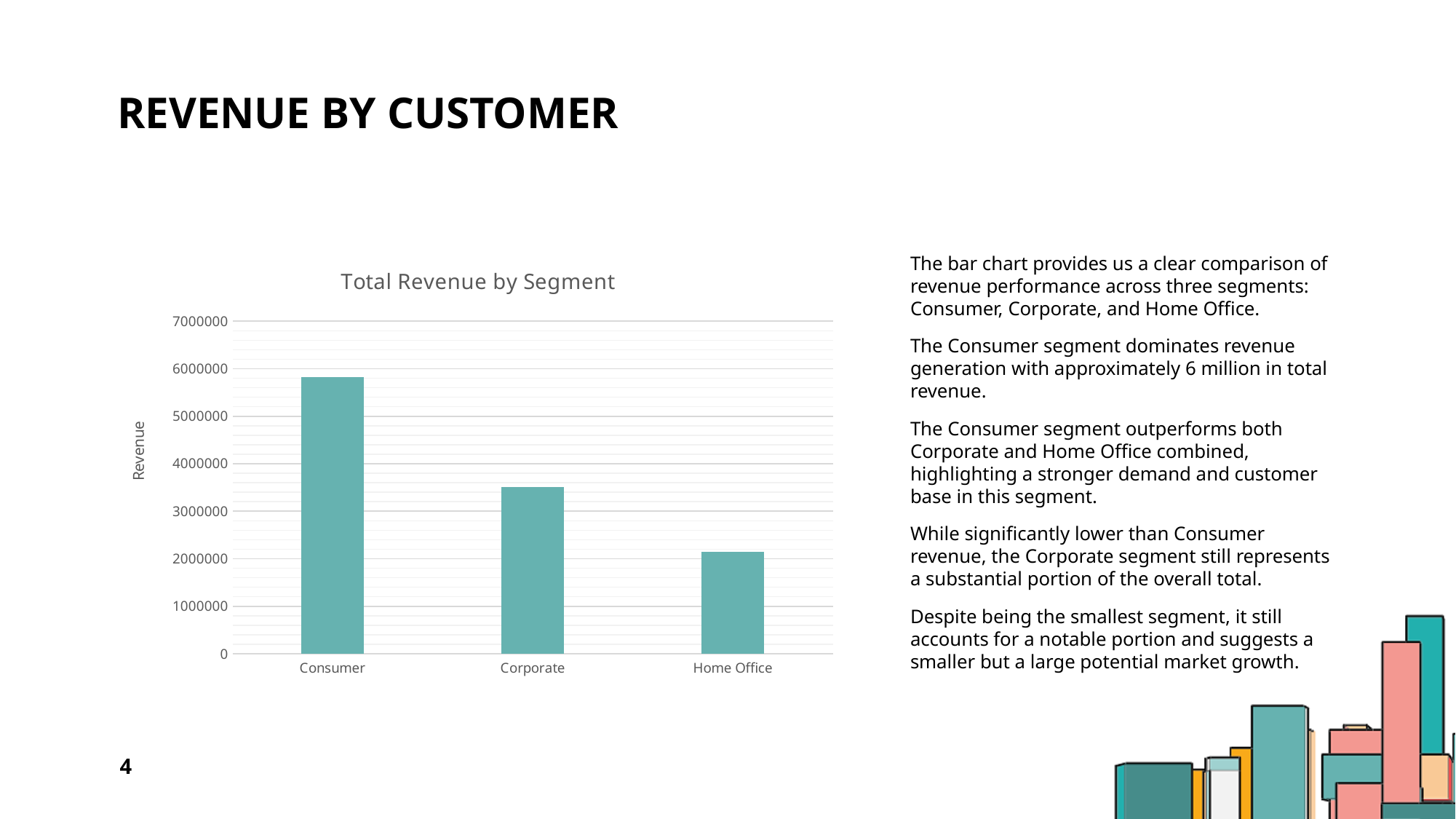
Which segment has higher revenue, Corporate or Home Office? Corporate How many segments are plotted in the chart? 3 Is the revenue for Home Office greater or less than 3000000? less Is the revenue for Consumer greater or less than 6000000? less What type of chart is shown on the slide? bar chart Do the revenue values rise or fall moving from Consumer to Home Office along the x axis? fall Is the revenue for Consumer greater or less than 5000000? greater Which segment has higher revenue, Consumer or Corporate? Consumer Which segment has the lowest total revenue? Home Office Which segment has the highest total revenue? Consumer What is the title of the chart? Total Revenue by Segment